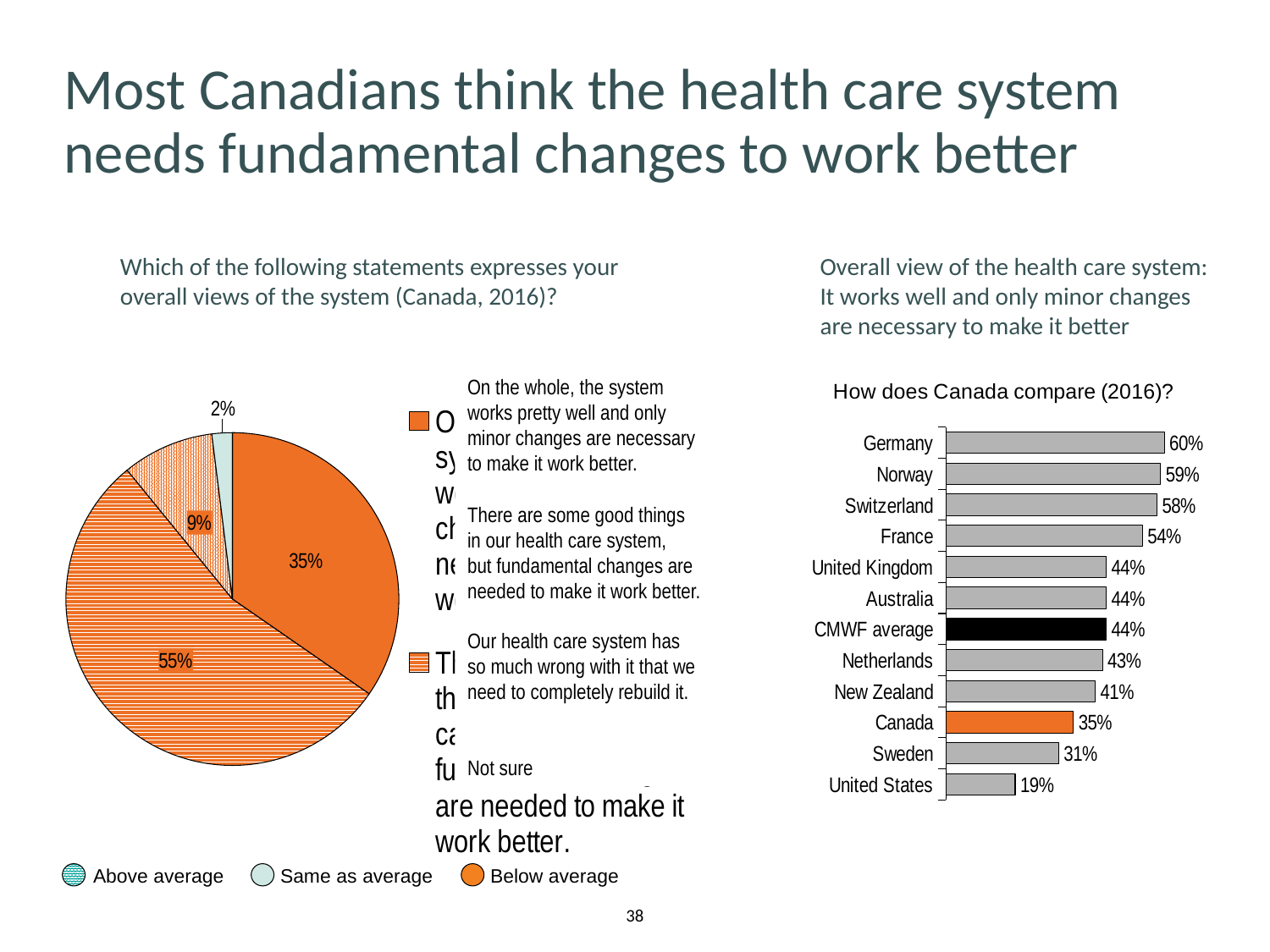
In the bar chart 'How does Canada compare (2016)?', which is larger, the value for Sweden or the value for New Zealand? New Zealand In the bar chart 'How does Canada compare (2016)?', what is the value for Germany? 60% What type of chart is the chart on the right side of the slide? Bar chart In the pie chart on the left, what percentage answered 'Not sure'? 2% In the bar chart 'How does Canada compare (2016)?', which country has the highest value? Germany In the bar chart 'How does Canada compare (2016)?', which country has the lowest value? United States In the bar chart 'How does Canada compare (2016)?', what is the difference between the CMWF average and Canada? 9% In the bar chart 'How does Canada compare (2016)?', what is the value for Canada? 35% How many bars are shown in the bar chart 'How does Canada compare (2016)?' 12 In the bar chart 'How does Canada compare (2016)?', what is the value for the CMWF average? 44% In the pie chart on the left, what share of Canadians said the system works pretty well and only minor changes are necessary? 35% In the pie chart on the left, what is the largest slice's value? 55%